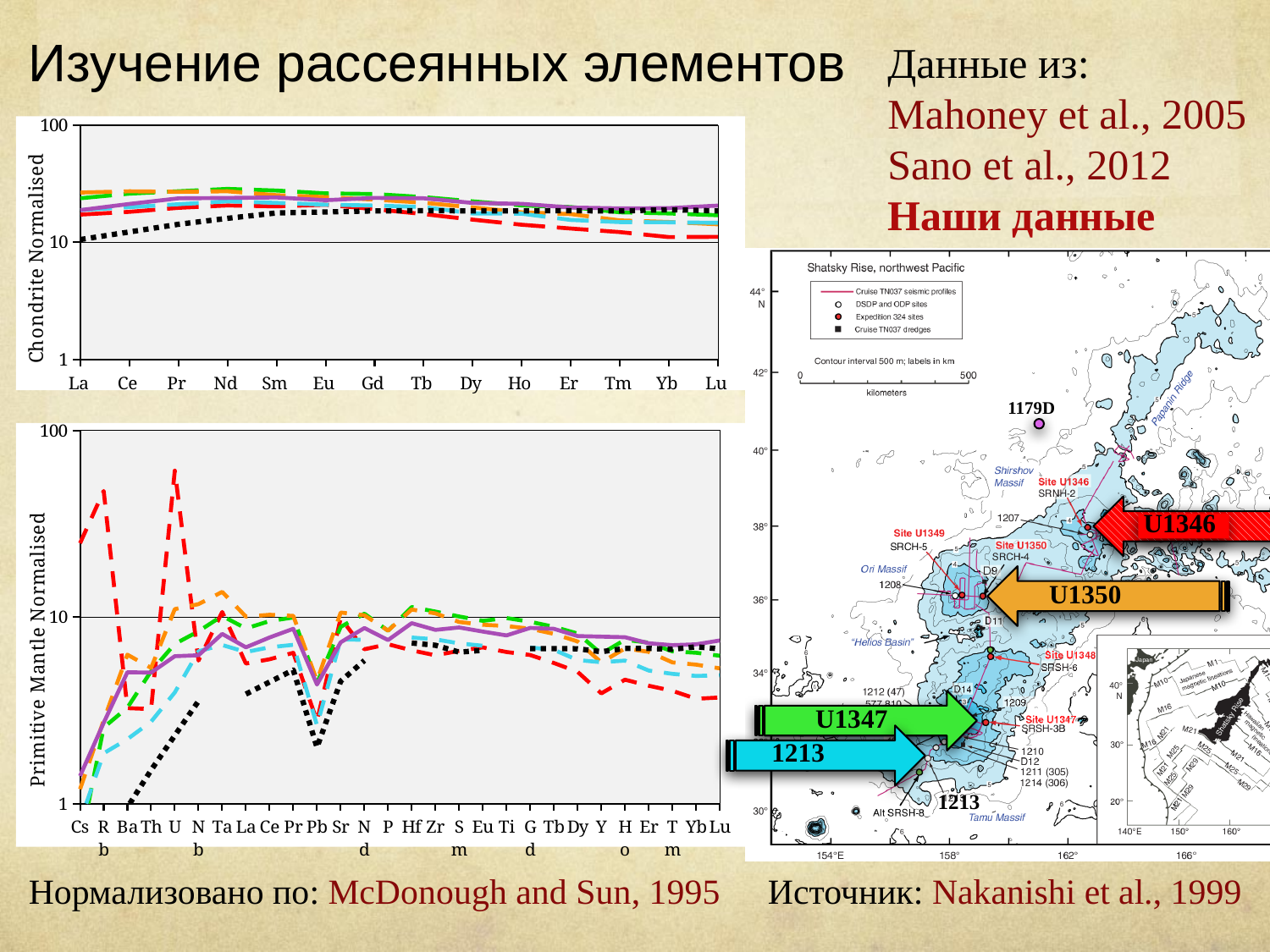
How many elements are shown along the x axis of the top chart (Chondrite Normalised)? 14 What is the y-axis label of the bottom chart? Primitive Mantle Normalised In the top chart (Chondrite Normalised), does the black dotted line rise or fall from La to Lu? rise In the bottom chart (Primitive Mantle Normalised), is the value of the red dashed line at U greater or less than 10? greater What kind of chart is the top chart (Chondrite Normalised)? line chart In the bottom chart (Primitive Mantle Normalised), at which element does the red dashed line reach its highest value? U In the top chart (Chondrite Normalised), is the value of the purple line at Nd greater or less than 10? greater What kind of chart is the bottom chart (Primitive Mantle Normalised)? line chart In the top chart (Chondrite Normalised), which line has the lowest value at La? the black dotted line How many elements are shown along the x axis of the bottom chart (Primitive Mantle Normalised)? 28 In the top chart (Chondrite Normalised), which is larger at Lu: the purple line or the red dashed line? the purple line In the bottom chart (Primitive Mantle Normalised), is the value of the black dotted line at Pb greater or less than 10? less